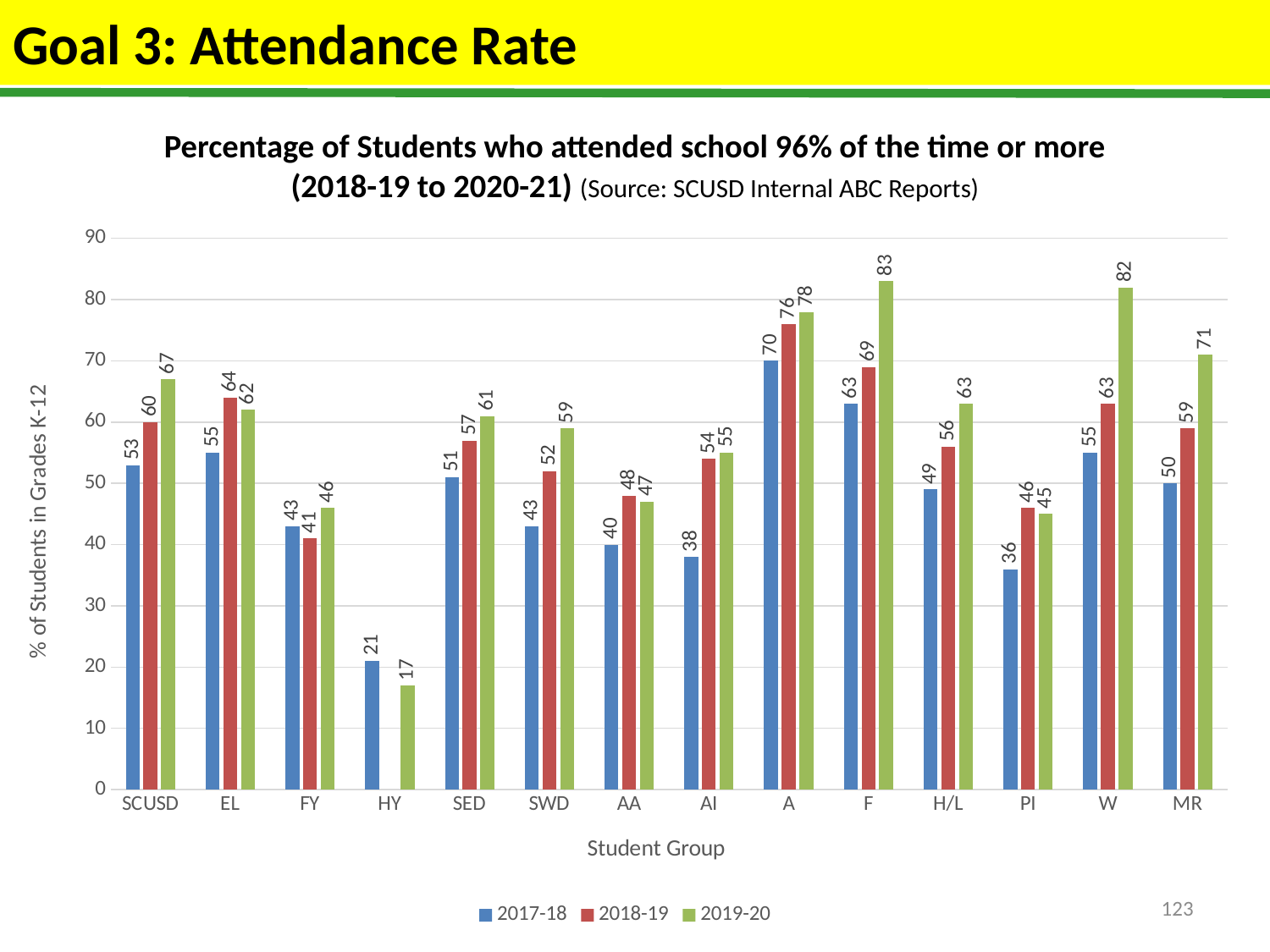
What kind of chart is shown on the slide? Bar chart What is the 2018-19 value for the PI student group? 46 What is the difference between the 2019-20 and 2017-18 values for the W student group? 27 What is the label of the y axis? % of Students in Grades K-12 Which student group has the lowest 2017-18 value? HY Which is larger for the EL student group, the 2018-19 value or the 2019-20 value? 2018-19 What is the 2017-18 value for SCUSD? 53 For the A student group, do the values rise or fall from 2017-18 to 2019-20? Rise How many student groups are shown on the x axis? 14 What is the 2019-20 value for the F student group? 83 Which student group has the highest 2019-20 value? F How many series does the legend list? 3